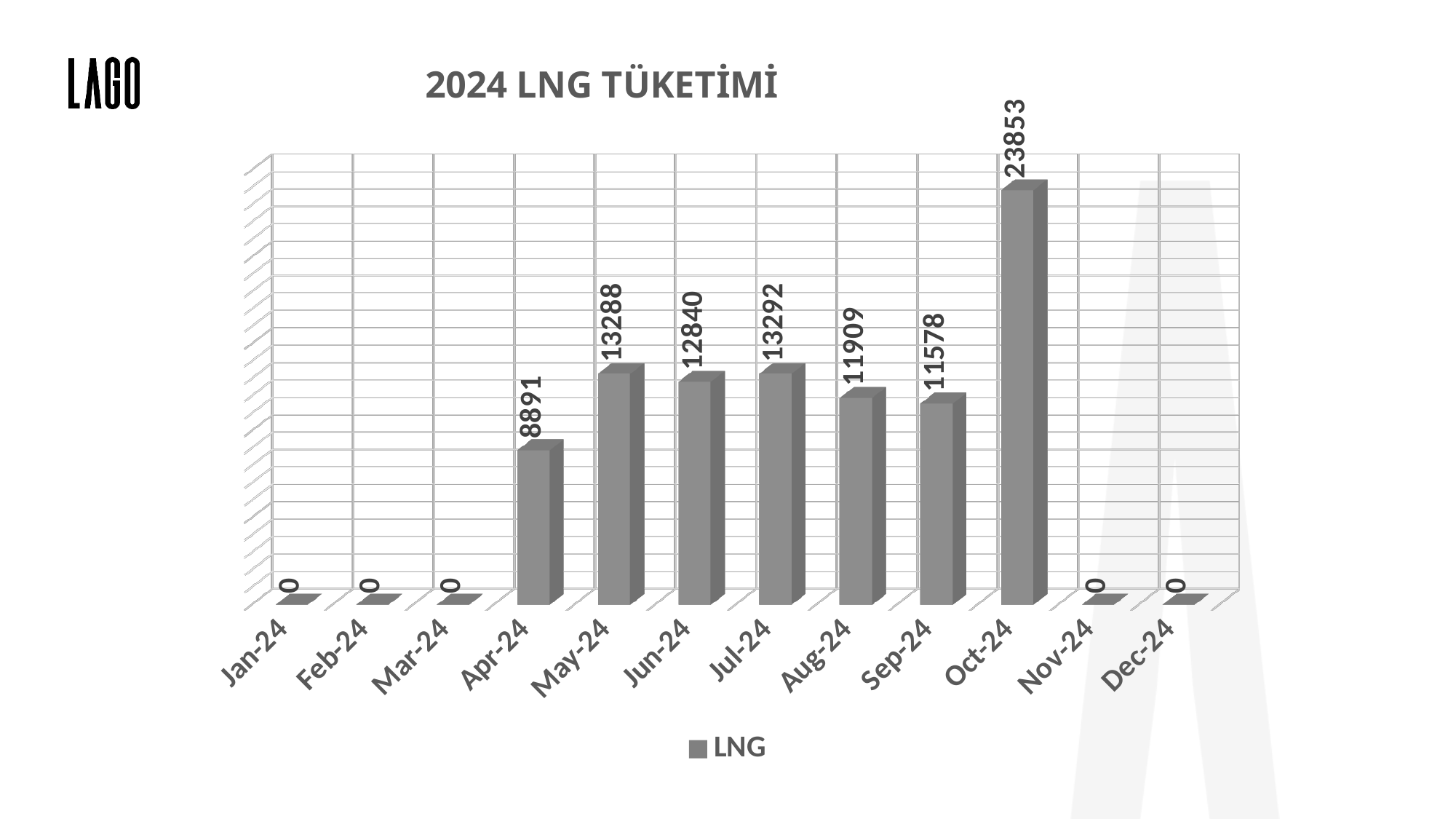
What is the difference between the LNG values for Oct-24 and May-24? 10565 What is the LNG value for Apr-24? 8891 What is the title of the chart? 2024 LNG TÜKETİMİ What kind of chart is shown on the slide? Bar chart What is the LNG value for Jan-24? 0 Which is larger, the LNG value for Apr-24 or for Aug-24? Aug-24 How many months are shown on the x axis? 12 What is the LNG value for Oct-24? 23853 What is the LNG value for Aug-24? 11909 How many series does the legend list? 1 Which month has the highest LNG value? Oct-24 What is the difference between the LNG values for Sep-24 and Apr-24? 2687